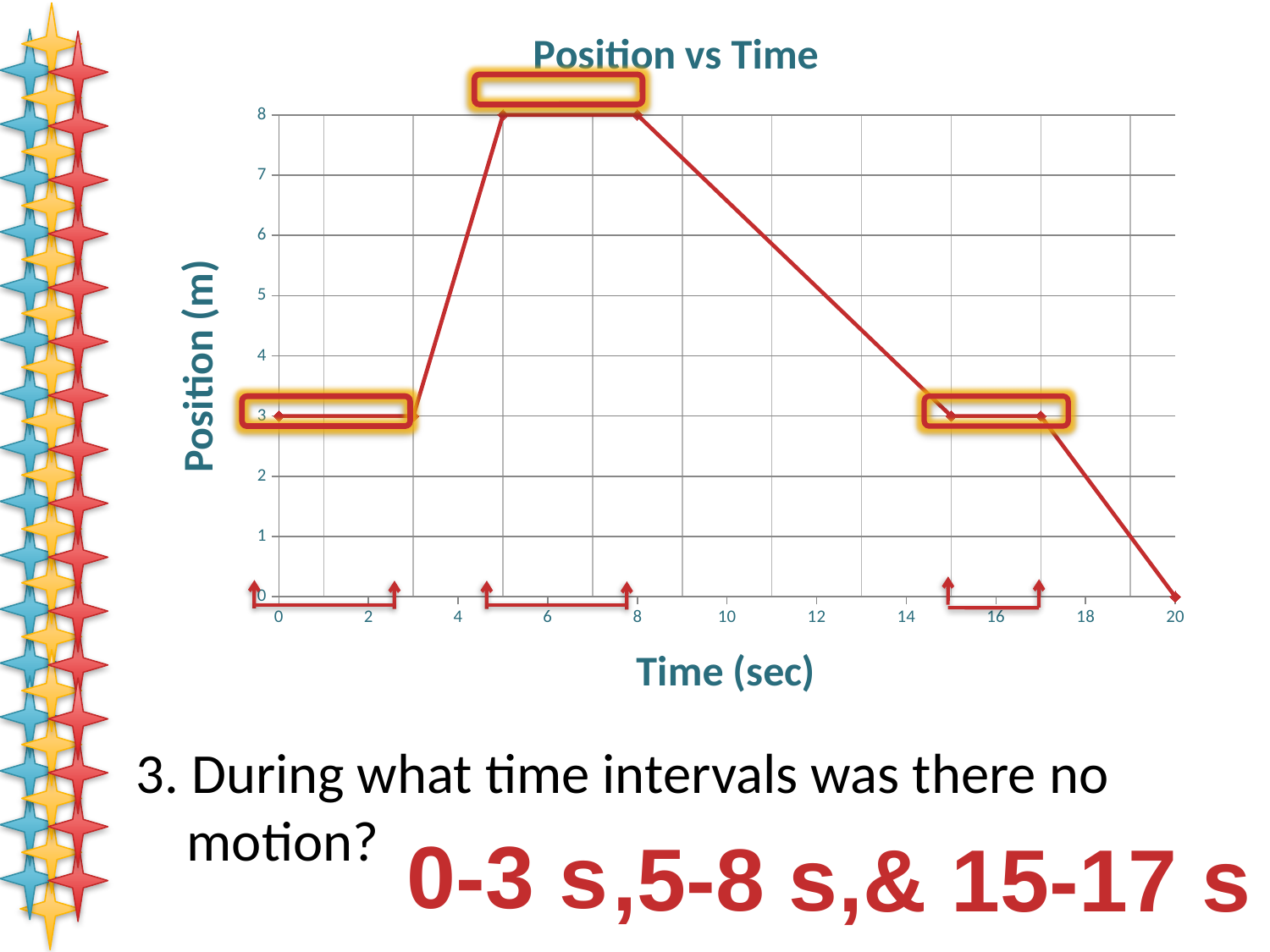
What is the title of the chart? Position vs Time What is the label of the vertical axis? Position (m) What is the difference between the position at 5 sec and the position at 15 sec? 5 Is the position at 4 sec greater or less than 4? greater What is the highest position reached on the chart? 8 What is the position at time 0 sec? 3 Does the position rise or fall between 8 sec and 15 sec? fall At what time is the position lowest? 20 What is the position at time 20 sec? 0 What kind of chart is shown on the slide? line chart Which is larger, the position at 5 sec or the position at 17 sec? 5 sec What is the position at time 8 sec? 8